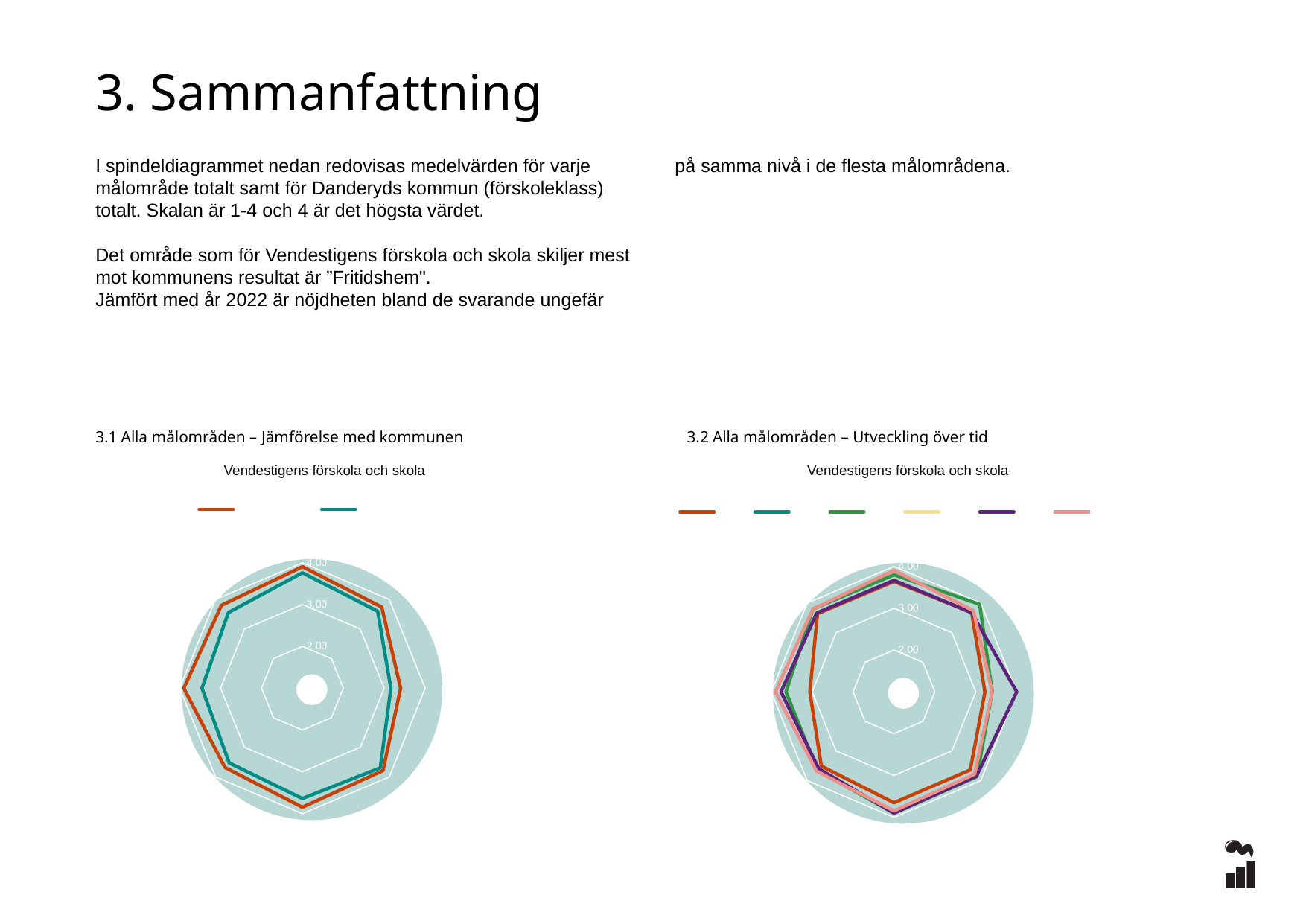
What is the title printed above the left chart (3.1 Jämförelse med kommunen)? Vendestigens förskola och skola How many axes (categories) does the right radar chart (3.2 Utveckling över tid) have? 8 How many series does the legend of the left chart (3.1 Jämförelse med kommunen) list? 2 How many axes (categories) does the left radar chart (3.1 Jämförelse med kommunen) have? 8 What kind of chart is the left chart (3.1 Alla målområden – Jämförelse med kommunen)? Radar chart How many series does the legend of the right chart (3.2 Utveckling över tid) list? 6 On the right chart (3.2 Utveckling över tid), are all plotted values greater or less than 2.00? greater What is the heading of the right chart? 3.2 Alla målområden – Utveckling över tid What kind of chart is the right chart (3.2 Alla målområden – Utveckling över tid)? Radar chart On the left chart (3.1 Jämförelse med kommunen), are all plotted values greater or less than 2.00? greater